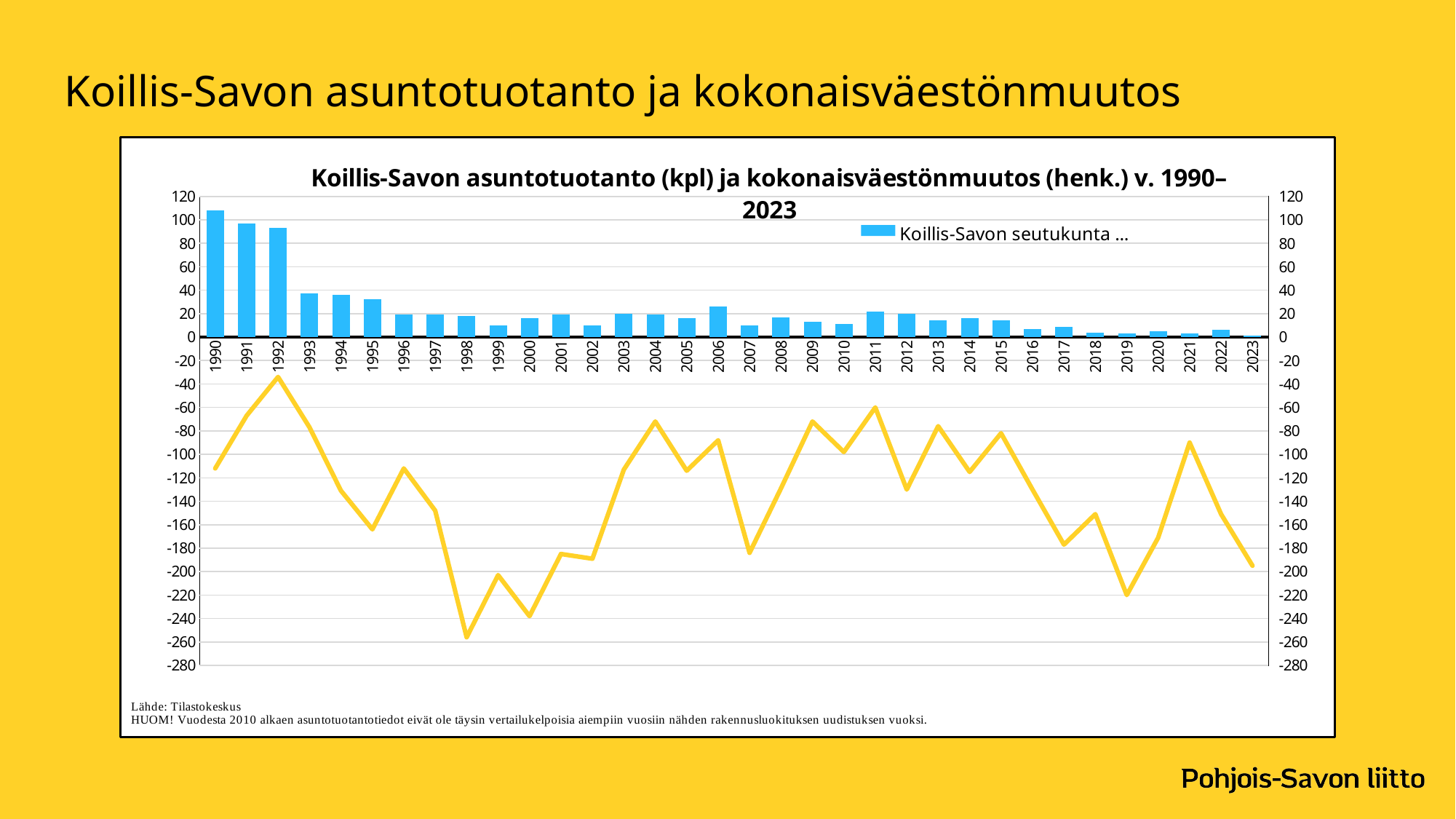
In which year does the population change line reach its lowest point? 1998 Is the line value for 2023 greater or less than -180? less Which year has the taller bar, 2006 or 2007? 2006 What kind of chart is shown on the slide? A combined bar and line chart Is the line value for 1998 greater or less than -240? less How many years are plotted along the x axis? 34 Is the bar value for 1992 greater or less than 100? less Which year has the tallest bar for housing production? 1990 In which year does the population change line reach its highest point? 1992 What colour are the bars in the chart? Blue Do the bar values rise or fall from 1990 to 1995? fall